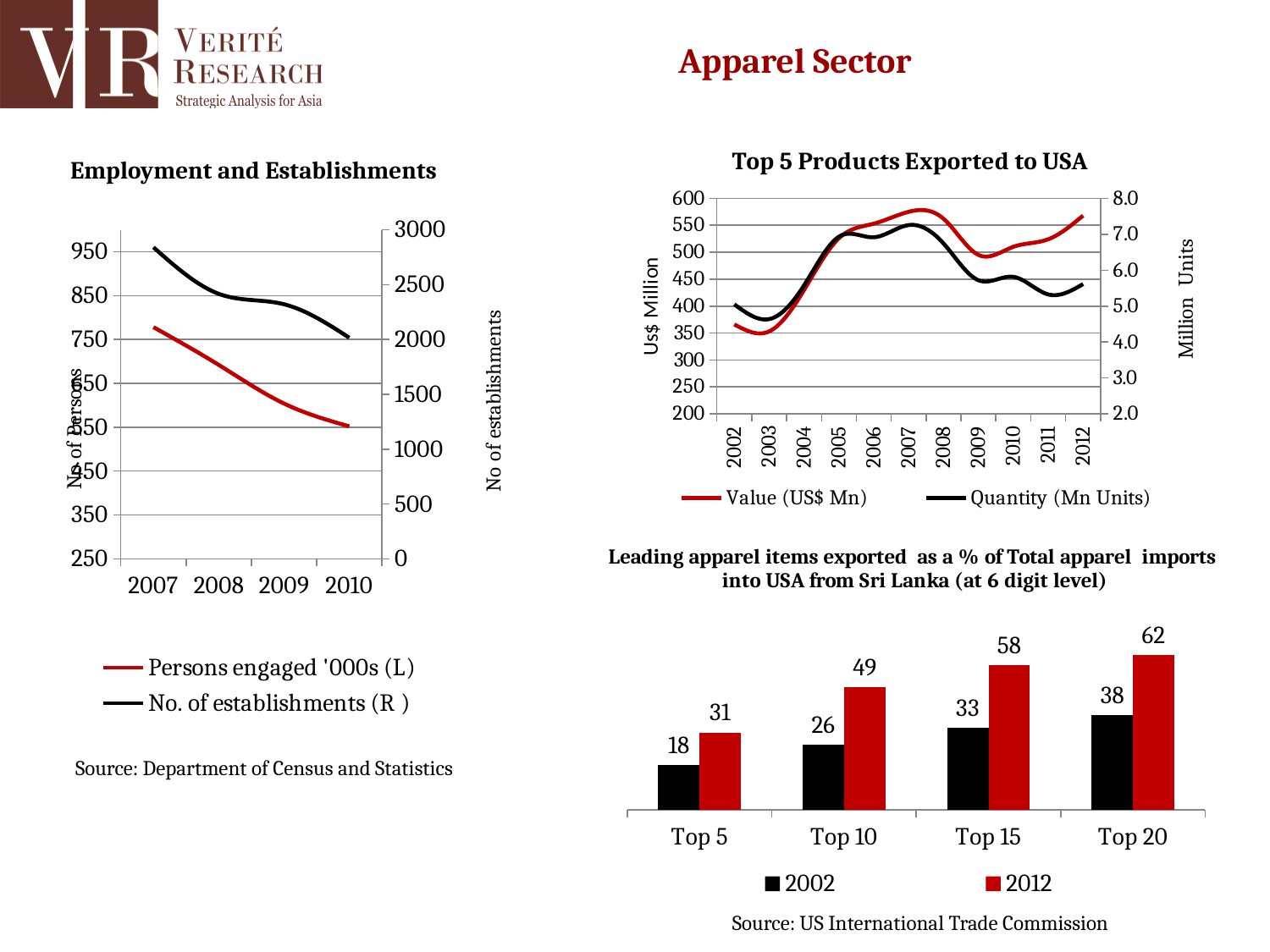
In the 'Top 5 Products Exported to USA' chart, is the Value (US$ Mn) in 2003 greater or less than 400? less In the 'Employment and Establishments' chart, do the Persons engaged values rise or fall from 2007 to 2010? Fall In the 'Leading apparel items exported' bar chart, what is the difference between the 2012 and 2002 values for Top 15? 25 How many categories are shown on the x axis of the 'Leading apparel items exported' bar chart? 4 How many series does the legend of the 'Top 5 Products Exported to USA' chart list? 2 In the 'Employment and Establishments' chart, is the value for No. of establishments in 2007 greater or less than 2500? greater In the 'Leading apparel items exported' bar chart, which is larger: the 2012 value for Top 5 or the 2002 value for Top 20? 2002 value for Top 20 What kind of chart is the 'Leading apparel items exported' chart? Bar chart In the 'Leading apparel items exported' bar chart, which category has the lowest 2002 value? Top 5 In the 'Leading apparel items exported' bar chart, what is the value for Top 20 in 2002? 38 In the 'Employment and Establishments' chart, is the value for Persons engaged in 2010 greater or less than 650? less In the 'Leading apparel items exported' bar chart, what is the value for Top 10 in 2012? 49